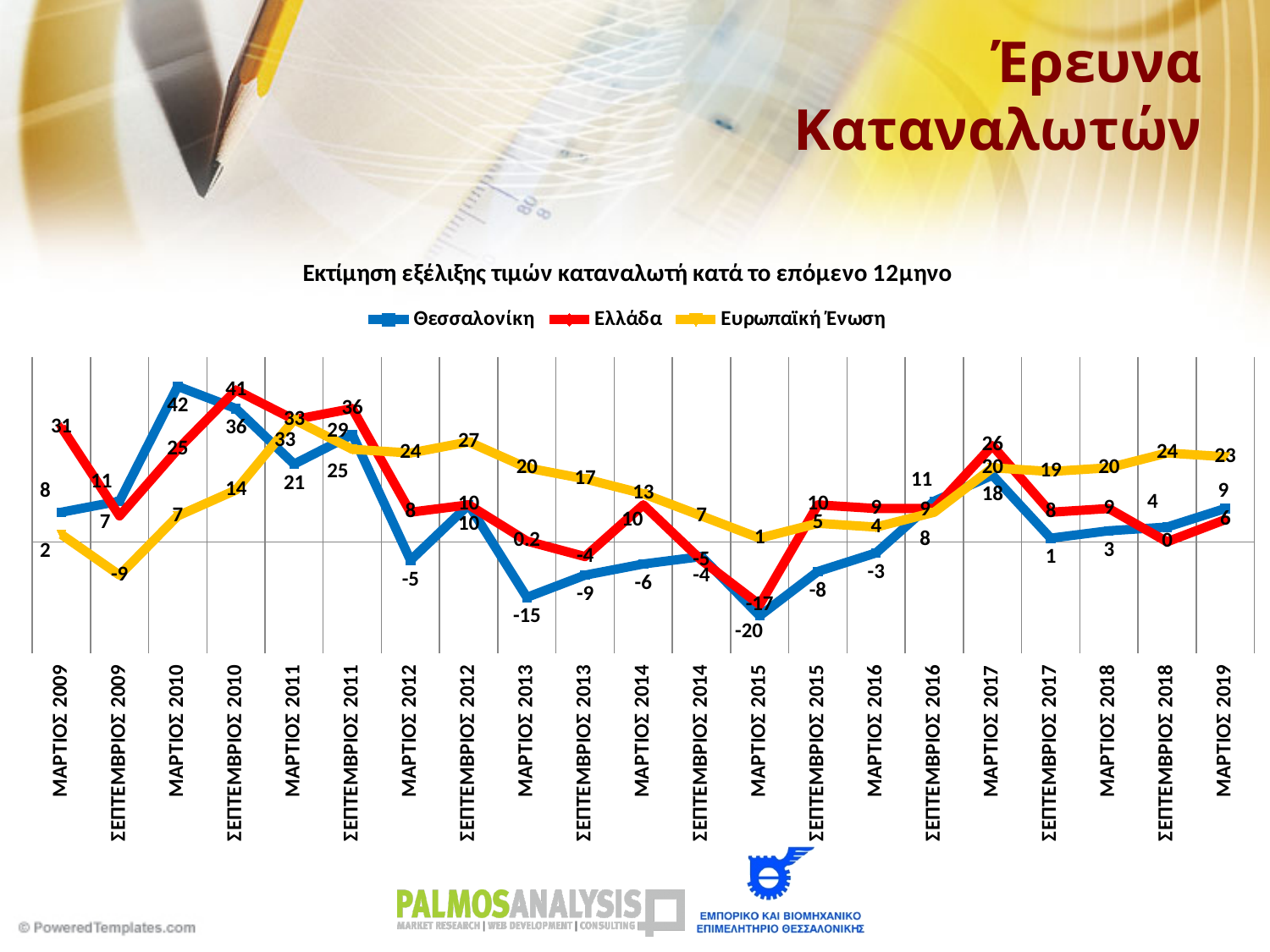
What is the value for Ελλάδα in ΜΑΡΤΙΟΣ 2009? 31 How many time points are plotted along the x axis? 21 What is the difference between the Ελλάδα and Θεσσαλονίκη values in ΜΑΡΤΙΟΣ 2017? 8 What type of chart is shown on the slide? line chart In which period does Ευρωπαϊκή Ένωση reach its lowest value? ΣΕΠΤΕΜΒΡΙΟΣ 2009 In which period does Ελλάδα reach its highest value? ΣΕΠΤΕΜΒΡΙΟΣ 2010 What is the value for Θεσσαλονίκη in ΜΑΡΤΙΟΣ 2010? 42 Which colour represents Ελλάδα in the chart? red In which period does Θεσσαλονίκη reach its lowest value? ΜΑΡΤΙΟΣ 2015 Which series has the larger value in ΜΑΡΤΙΟΣ 2012, Θεσσαλονίκη or Ευρωπαϊκή Ένωση? Ευρωπαϊκή Ένωση How many series does the legend list? 3 What is the value for Ευρωπαϊκή Ένωση in ΣΕΠΤΕΜΒΡΙΟΣ 2018? 24